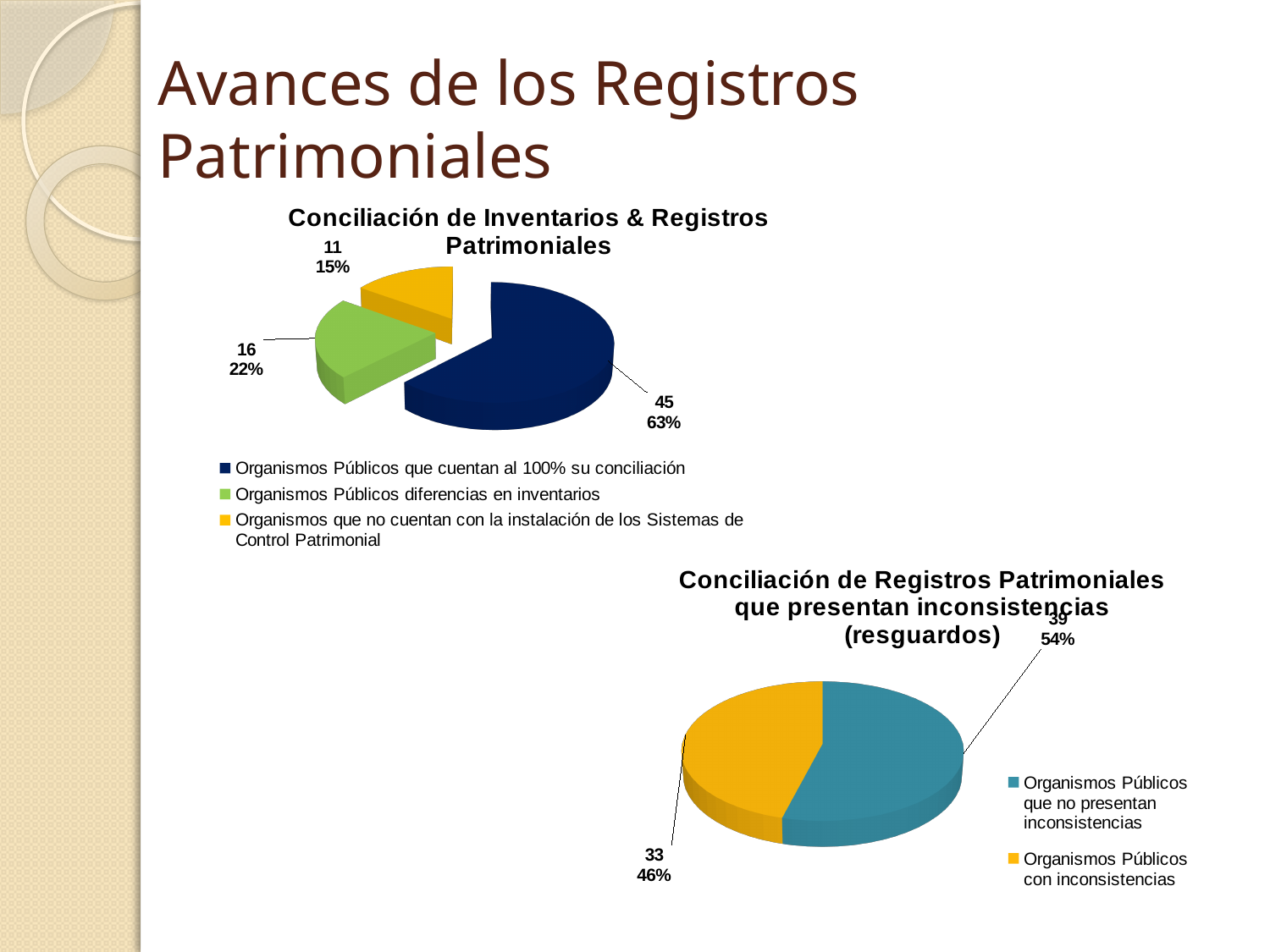
How many slices does the chart titled 'Conciliación de Inventarios & Registros Patrimoniales' have? 3 In the chart titled 'Conciliación de Registros Patrimoniales que presentan inconsistencias (resguardos)', what is the value for 'Organismos Públicos que no presentan inconsistencias'? 39 In the chart titled 'Conciliación de Inventarios & Registros Patrimoniales', which category has the smallest slice? Organismos que no cuentan con la instalación de los Sistemas de Control Patrimonial In the chart titled 'Conciliación de Inventarios & Registros Patrimoniales', what share of the pie is 'Organismos Públicos diferencias en inventarios'? 22% In the chart titled 'Conciliación de Registros Patrimoniales que presentan inconsistencias (resguardos)', which is larger: 'Organismos Públicos que no presentan inconsistencias' or 'Organismos Públicos con inconsistencias'? Organismos Públicos que no presentan inconsistencias In the chart titled 'Conciliación de Registros Patrimoniales que presentan inconsistencias (resguardos)', what share of the pie is 'Organismos Públicos con inconsistencias'? 46% In the chart titled 'Conciliación de Inventarios & Registros Patrimoniales', what is the difference between the values for 'Organismos Públicos que cuentan al 100% su conciliación' and 'Organismos Públicos diferencias en inventarios'? 29 In the chart titled 'Conciliación de Inventarios & Registros Patrimoniales', what is the value for 'Organismos que no cuentan con la instalación de los Sistemas de Control Patrimonial'? 11 In the chart titled 'Conciliación de Inventarios & Registros Patrimoniales', which category has the largest slice? Organismos Públicos que cuentan al 100% su conciliación In the chart titled 'Conciliación de Registros Patrimoniales que presentan inconsistencias (resguardos)', what colour is the slice for 'Organismos Públicos con inconsistencias'? Yellow What kind of chart is the chart titled 'Conciliación de Registros Patrimoniales que presentan inconsistencias (resguardos)'? Pie chart In the chart titled 'Conciliación de Inventarios & Registros Patrimoniales', what is the value for 'Organismos Públicos que cuentan al 100% su conciliación'? 45